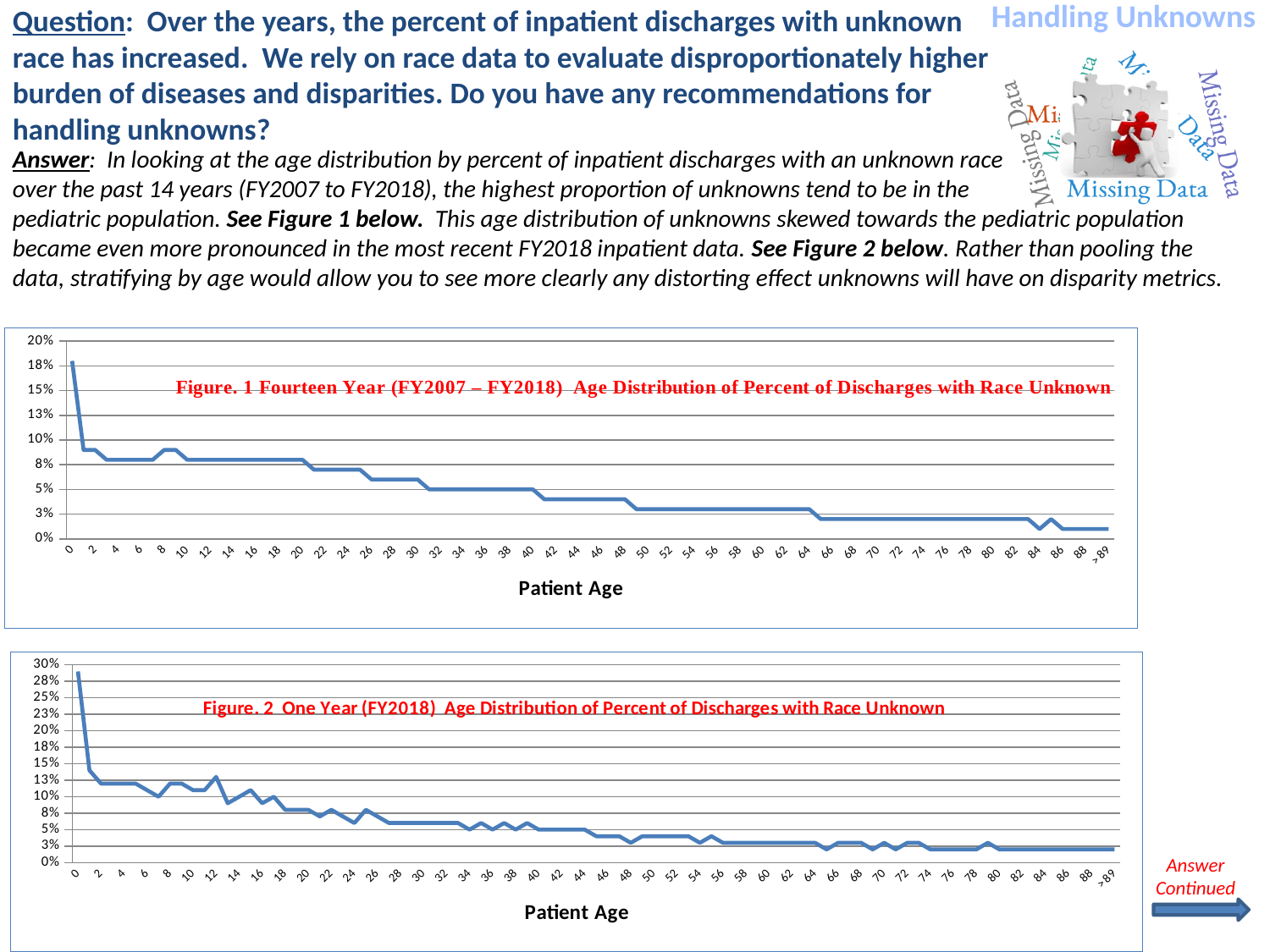
What is the x-axis title of Figure 2? Patient Age In Figure 1, is the value for patient age 30 greater or less than 8%? less In Figure 2, is the value for patient age 0 greater or less than 25%? greater In Figure 2, which patient age has the highest percent of discharges with race unknown? 0 In Figure 2, is the value for patient age 60 greater or less than 5%? less In Figure 2, do the values generally rise or fall as patient age increases? fall What kind of chart is Figure 1? line chart In Figure 1, do the values generally rise or fall as patient age increases? fall In Figure 1, which patient age has the highest percent of discharges with race unknown? 0 What kind of chart is Figure 2? line chart